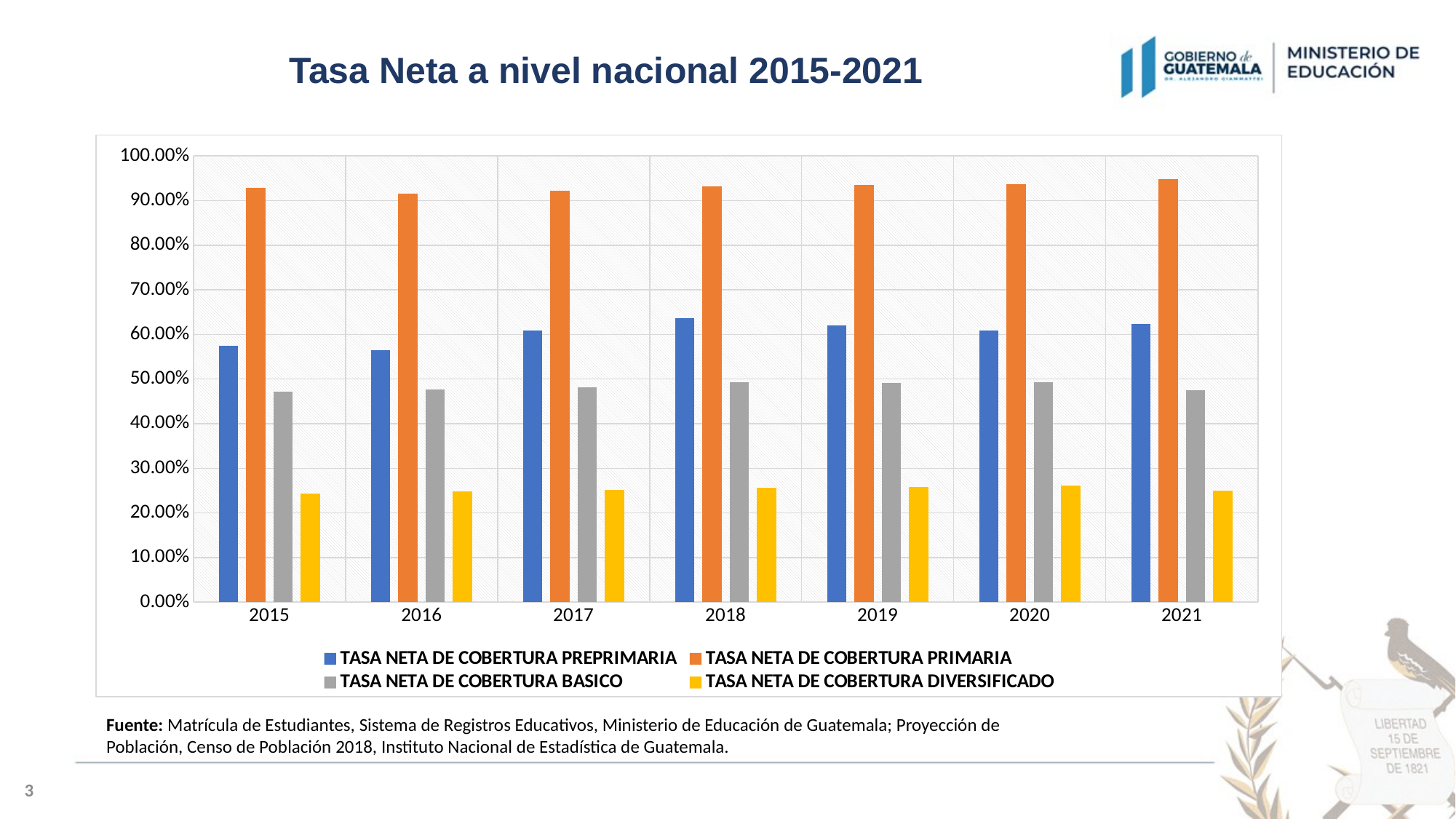
How many series does the chart legend list? 4 What is the title of the slide's chart? Tasa Neta a nivel nacional 2015-2021 In 2019, which is larger: TASA NETA DE COBERTURA PRIMARIA or TASA NETA DE COBERTURA BASICO? TASA NETA DE COBERTURA PRIMARIA Is the value for TASA NETA DE COBERTURA PREPRIMARIA in 2018 greater or less than 60.00%? greater In which year is TASA NETA DE COBERTURA PRIMARIA highest? 2021 Which series has the lowest values in every year shown? TASA NETA DE COBERTURA DIVERSIFICADO Is the value for TASA NETA DE COBERTURA PREPRIMARIA in 2016 greater or less than 60.00%? less Is the value for TASA NETA DE COBERTURA DIVERSIFICADO in 2020 greater or less than 20.00%? greater How many years are shown on the x axis of the chart? 7 What kind of chart is shown on the slide? bar chart